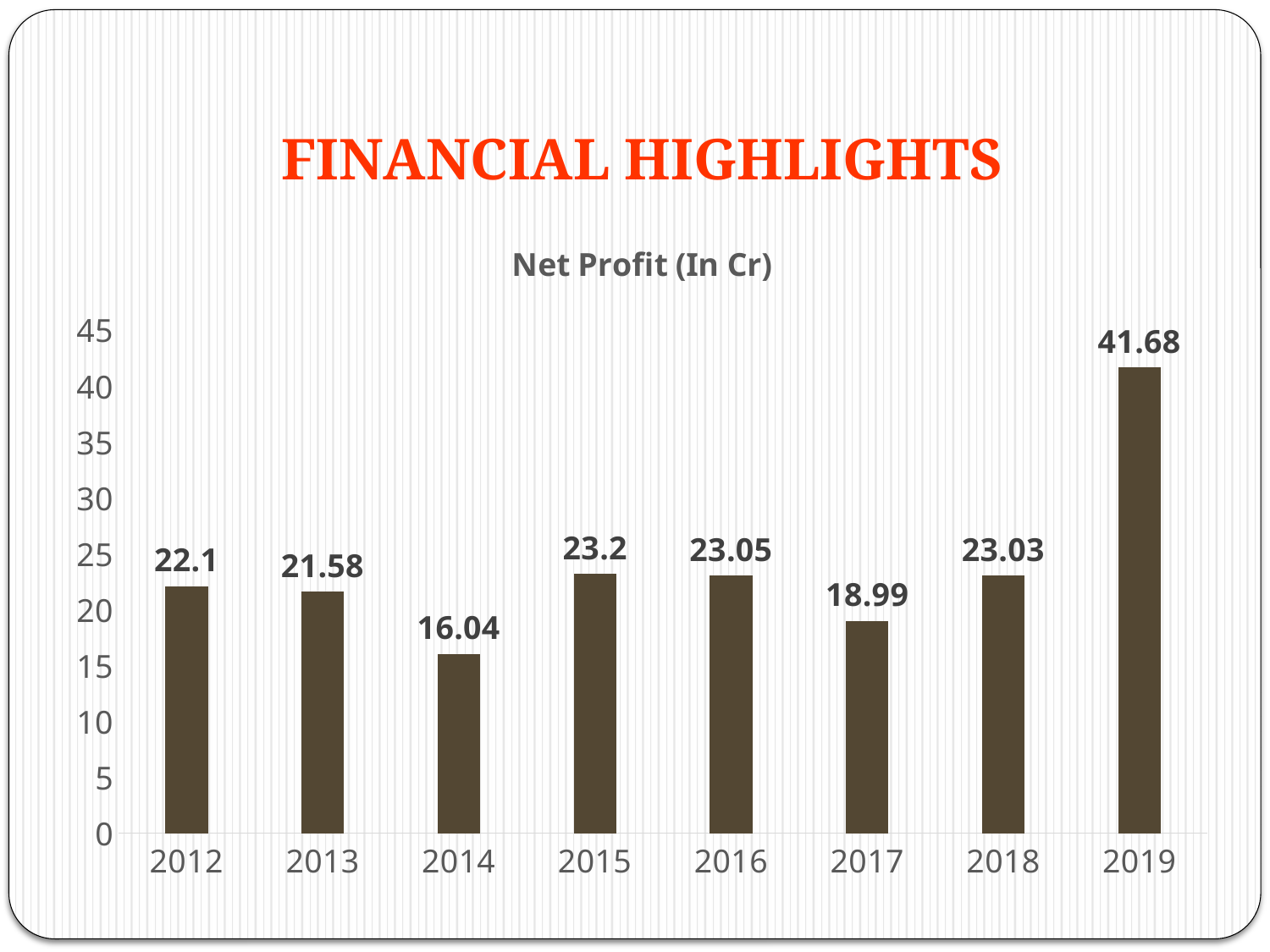
What type of chart is shown on the slide? Bar chart How many years are shown on the chart? 8 What is the net profit for 2014? 16.04 What is the net profit for 2017? 18.99 What is the net profit for 2019? 41.68 What is the difference in net profit between 2019 and 2018? 18.65 Which year has a larger net profit, 2015 or 2017? 2015 What is the title of the chart? Net Profit (In Cr) Which year has the lowest net profit? 2014 Which year has the highest net profit? 2019 Is the net profit for 2019 greater or less than 40? greater What is the difference in net profit between 2012 and 2013? 0.52